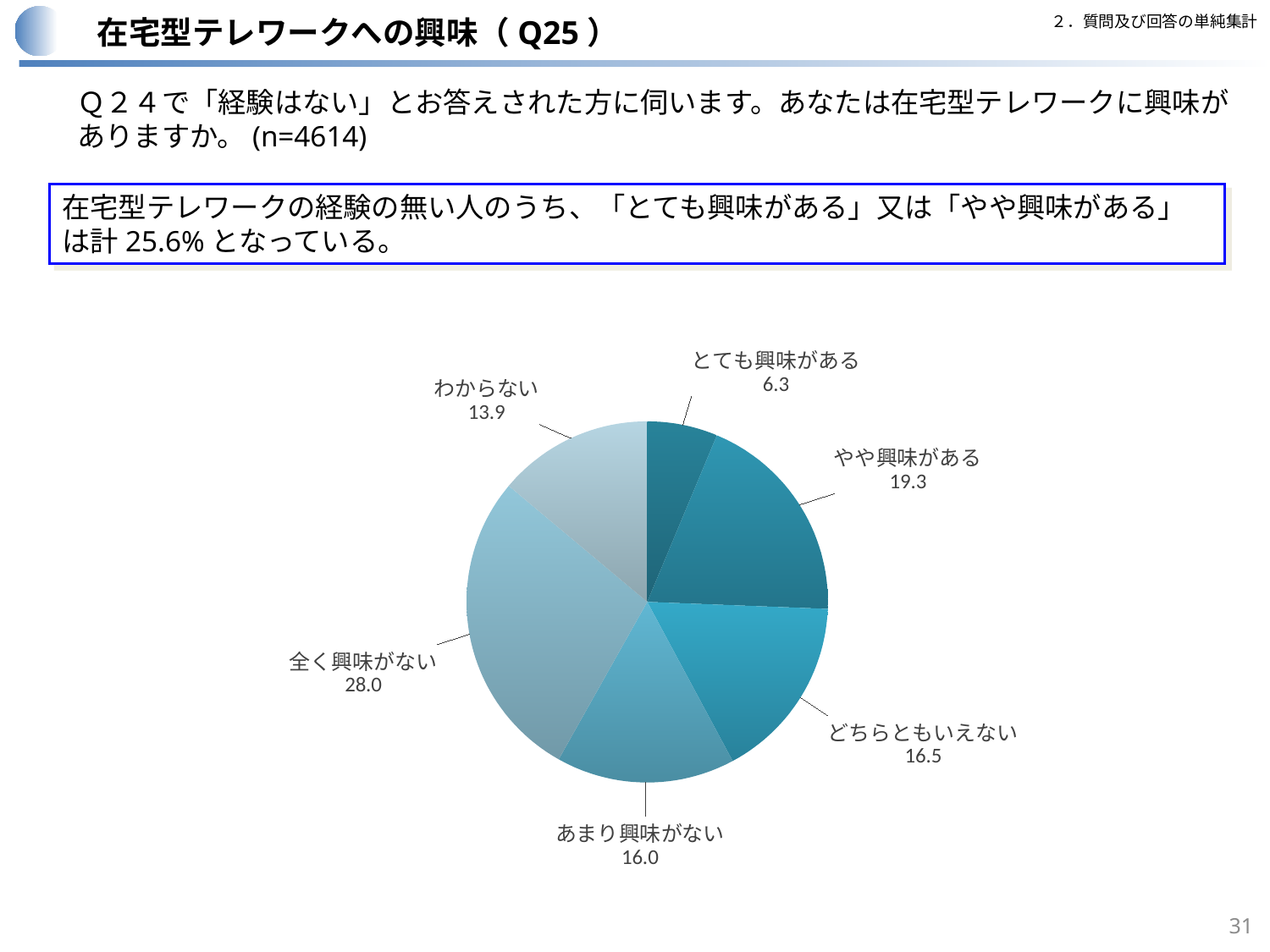
What kind of chart is shown on the slide? Pie chart What is the value for 「わからない」 in the pie chart? 13.9 Which is larger, the value for 「どちらともいえない」 or the value for 「あまり興味がない」? どちらともいえない What is the difference between the values for 「全く興味がない」 and 「やや興味がある」? 8.7 What is the value for 「全く興味がない」 in the pie chart? 28.0 What is the sample size (n) stated in the question text above the chart? 4614 How many categories are shown in the pie chart? 6 Which category has the smallest slice in the pie chart? とても興味がある Which category has the largest slice in the pie chart? 全く興味がない What is the value for 「とても興味がある」 in the pie chart? 6.3 What is the value for 「やや興味がある」 in the pie chart? 19.3 What is the combined value of 「とても興味がある」 and 「やや興味がある」? 25.6